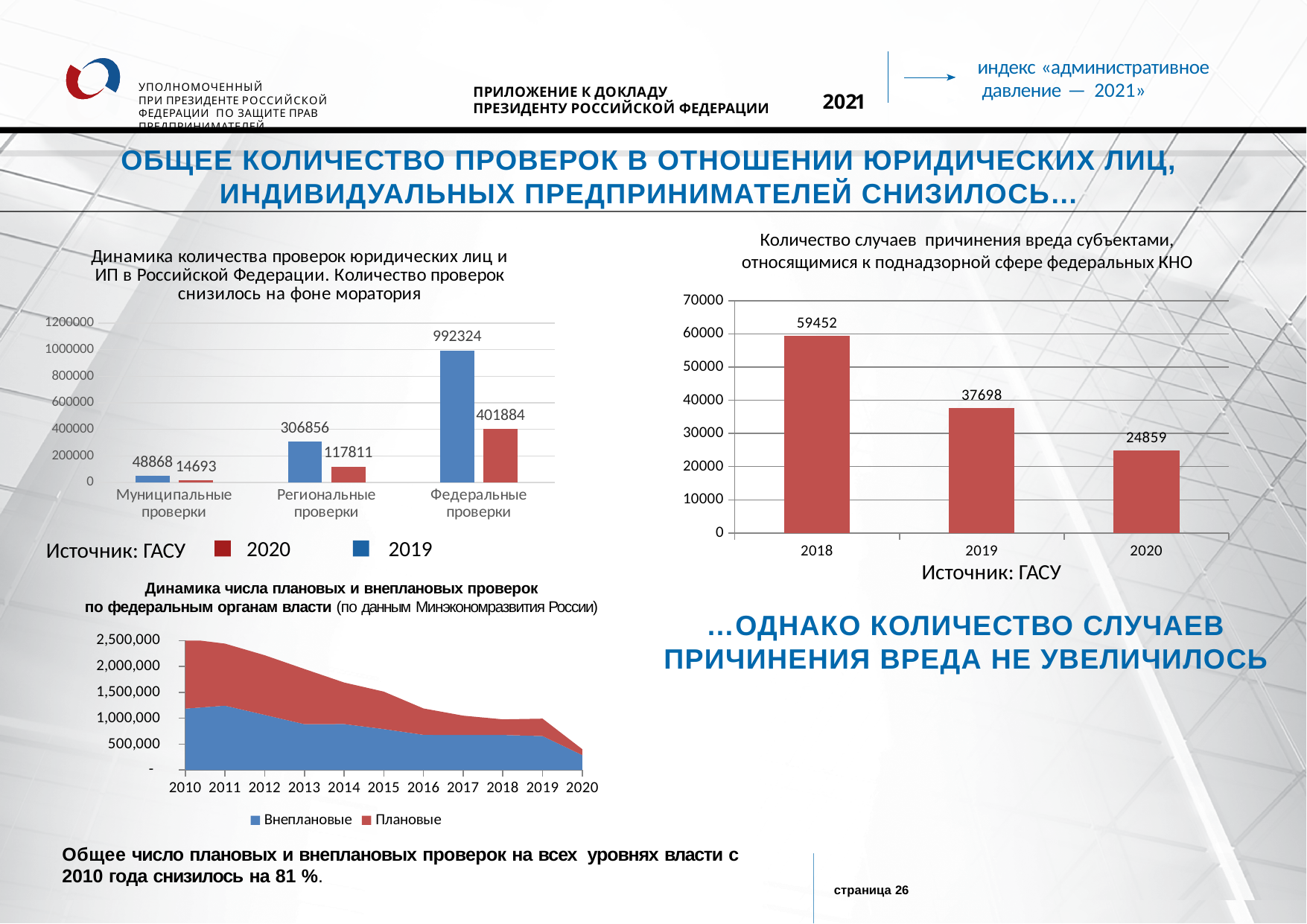
In the top-left chart on the dynamics of inspections, what is the 2020 value for Региональные проверки? 117811 In the top-left chart on the dynamics of inspections of legal entities and sole proprietors, what is the 2019 value for Федеральные проверки? 992324 In the top-right chart on the number of harm cases, do the values rise or fall from 2018 to 2020? fall In the bottom-left chart on planned and unplanned inspections, which series is shown in blue? Внеплановые In the top-right chart on the number of harm cases, which year has the lowest value? 2020 In the bottom-left chart on planned and unplanned inspections by federal authorities, how many years are shown on the x axis? 11 In the top-left chart on the dynamics of inspections, how many categories are shown on the x axis? 3 In the top-left chart on the dynamics of inspections, which is larger: the 2020 value for Федеральные проверки or the 2019 value for Региональные проверки? 2020 value for Федеральные проверки In the top-right chart on the number of harm cases, what is the difference between the 2019 and 2020 values? 12839 In the top-left chart on the dynamics of inspections, how many series does the legend list? 2 In the top-right chart on the number of harm cases (Количество случаев причинения вреда), what is the value for 2018? 59452 In the top-left chart on the dynamics of inspections, what is the difference between the 2019 and 2020 values for Муниципальные проверки? 34175